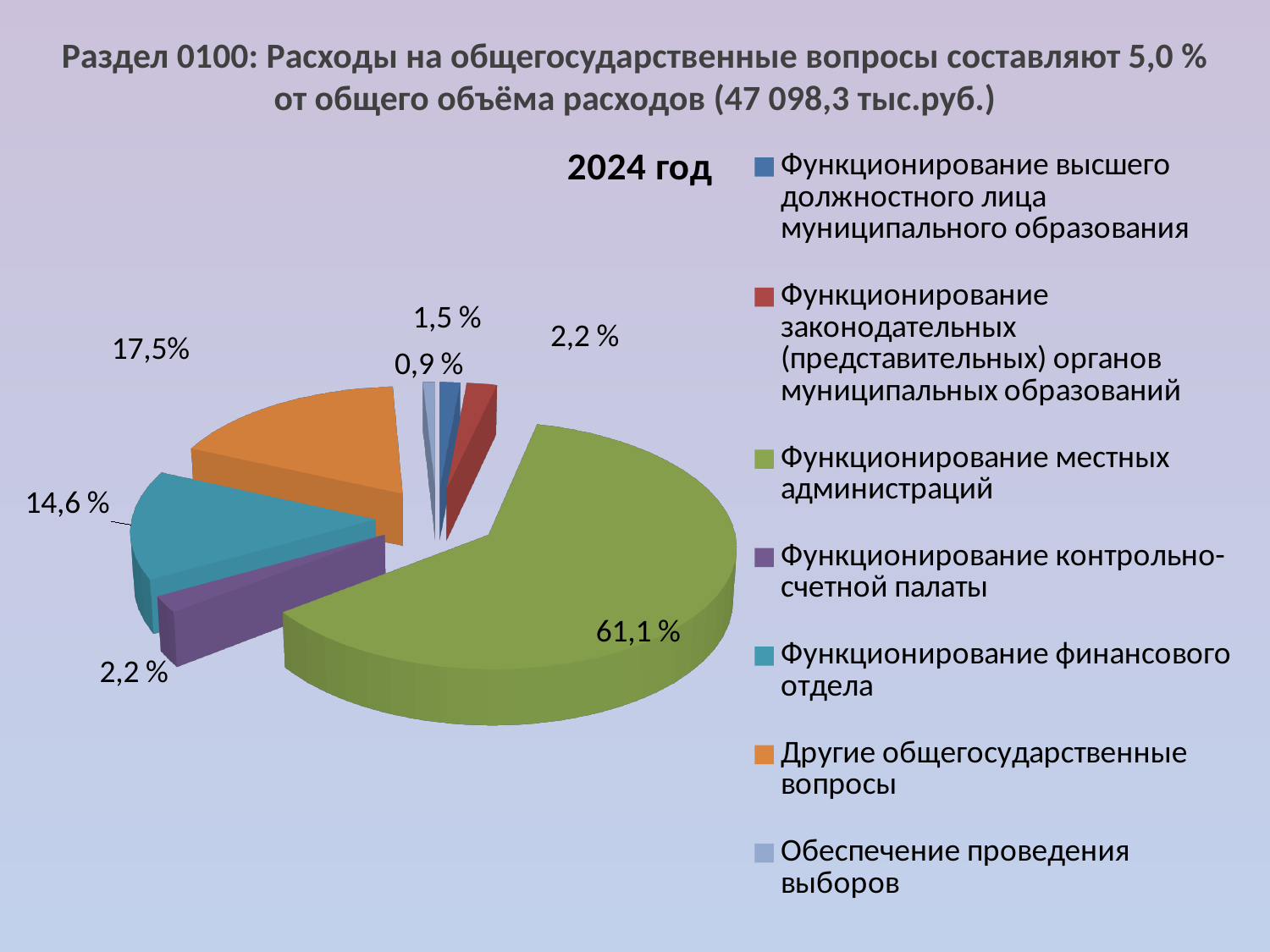
What is the title of the chart? 2024 год What is the difference between the shares of Другие общегосударственные вопросы and Функционирование финансового отдела? 2,9 % What share of the pie does Обеспечение проведения выборов have? 0,9 % What share of the pie does Функционирование высшего должностного лица муниципального образования have? 1,5 % Which category has the smallest slice of the pie? Обеспечение проведения выборов How many categories does the legend list? 7 What kind of chart is shown on the slide? Pie chart Which is larger: the share of Функционирование финансового отдела or the share of Функционирование контрольно-счетной палаты? Функционирование финансового отдела What share of the pie does Функционирование местных администраций have? 61,1 % What share of the pie does Функционирование финансового отдела have? 14,6 % Which category has the largest slice of the pie? Функционирование местных администраций What share of the pie does Другие общегосударственные вопросы have? 17,5%